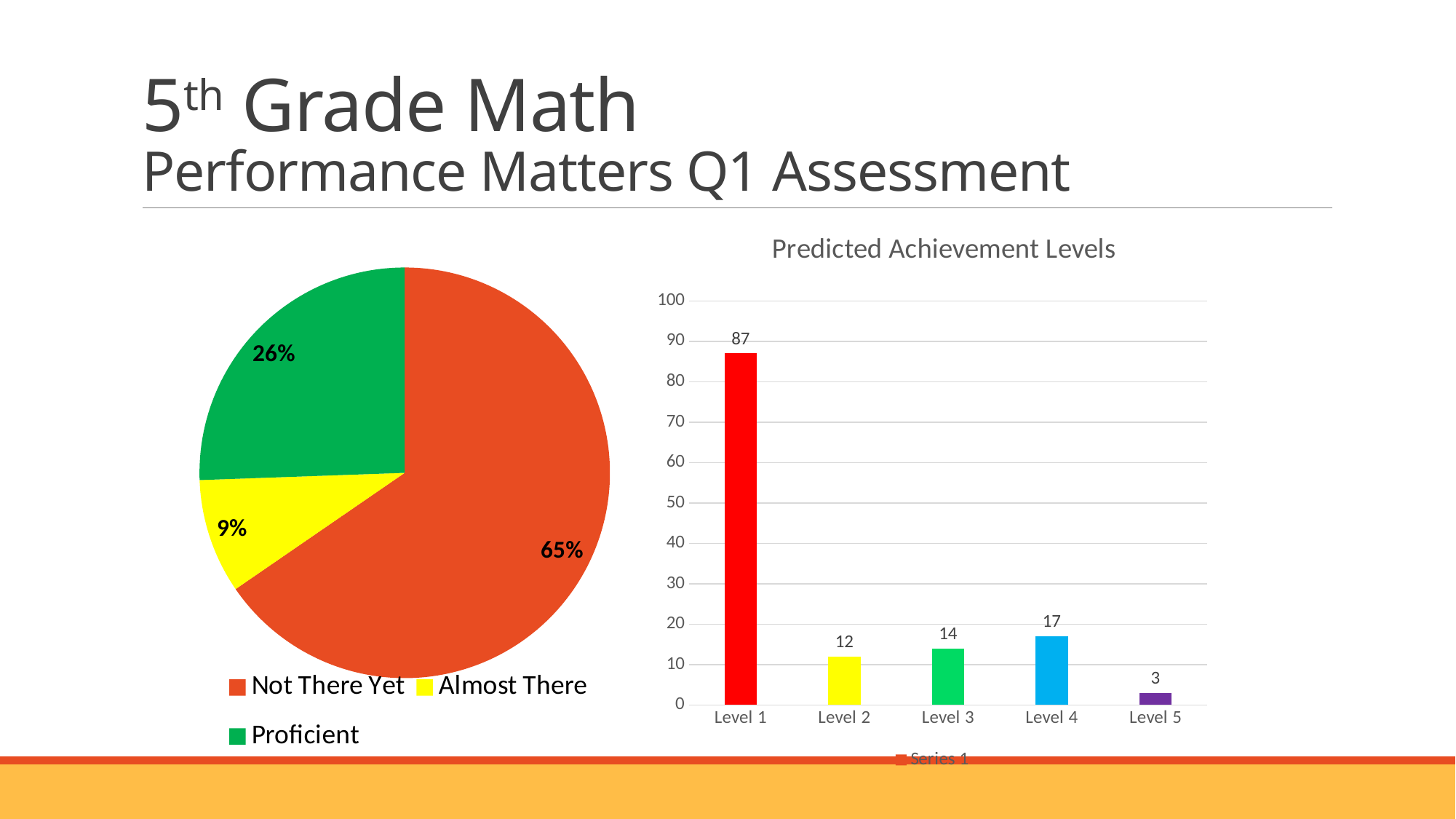
In the pie chart on the left, which category has the smallest slice? Almost There In the Predicted Achievement Levels chart, what is the value for Level 1? 87 In the pie chart on the left, what share does Proficient have? 26% In the pie chart on the left, which category has the largest slice? Not There Yet In the Predicted Achievement Levels chart, what is the difference between Level 1 and Level 4? 70 What kind of chart is the Predicted Achievement Levels chart? Bar chart In the Predicted Achievement Levels chart, what is the value for Level 5? 3 In the Predicted Achievement Levels chart, which level has the lowest value? Level 5 In the pie chart on the left, how many categories does the legend list? 3 In the Predicted Achievement Levels chart, which is larger, Level 2 or Level 3? Level 3 In the pie chart on the left, what share does Not There Yet have? 65% In the pie chart on the left, what share does Almost There have? 9%